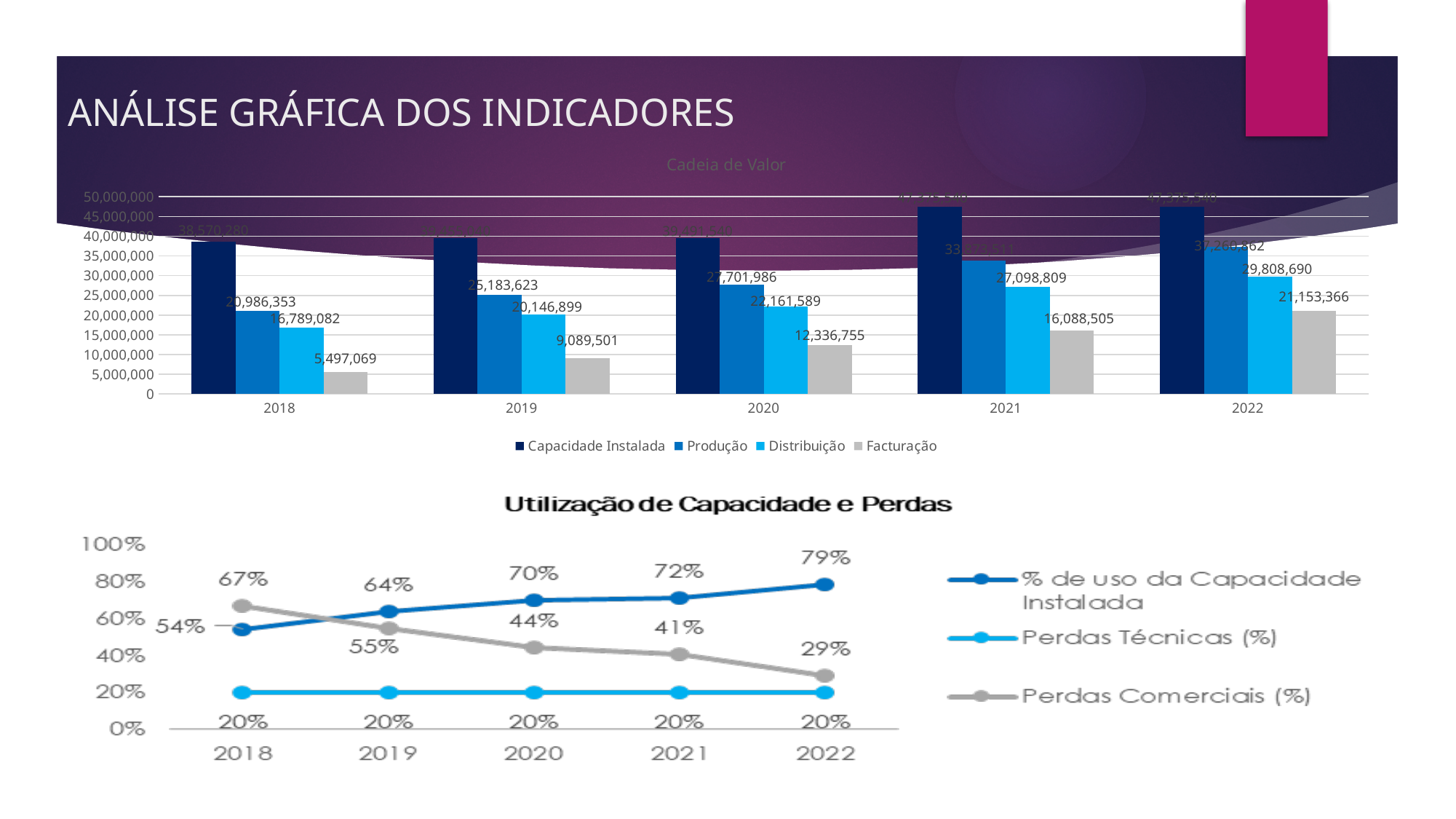
In the 'Utilização de Capacidade e Perdas' chart, what is the 'Perdas Comerciais (%)' value for 2019? 55% What kind of chart is the 'Cadeia de Valor' chart? bar chart In the 'Utilização de Capacidade e Perdas' chart, what is the '% de uso da Capacidade Instalada' value for 2022? 79% In the 'Cadeia de Valor' chart, what is the Facturação value for 2018? 5,497,069 In the 'Cadeia de Valor' chart, what is the Produção value for 2020? 27,701,986 In the 'Cadeia de Valor' chart, which year has the highest Facturação? 2022 In the 'Utilização de Capacidade e Perdas' chart, how many years are shown on the x axis? 5 In the 'Cadeia de Valor' chart, is the Capacidade Instalada value for 2021 greater or less than 40,000,000? greater In the 'Cadeia de Valor' chart, what is the Distribuição value for 2022? 29,808,690 In the 'Cadeia de Valor' chart, what is the difference between Facturação in 2021 and Facturação in 2020? 3,751,750 In the 'Utilização de Capacidade e Perdas' chart, does 'Perdas Comerciais (%)' rise or fall from 2018 to 2022? fall In the 'Cadeia de Valor' chart, how many series does the legend list? 4